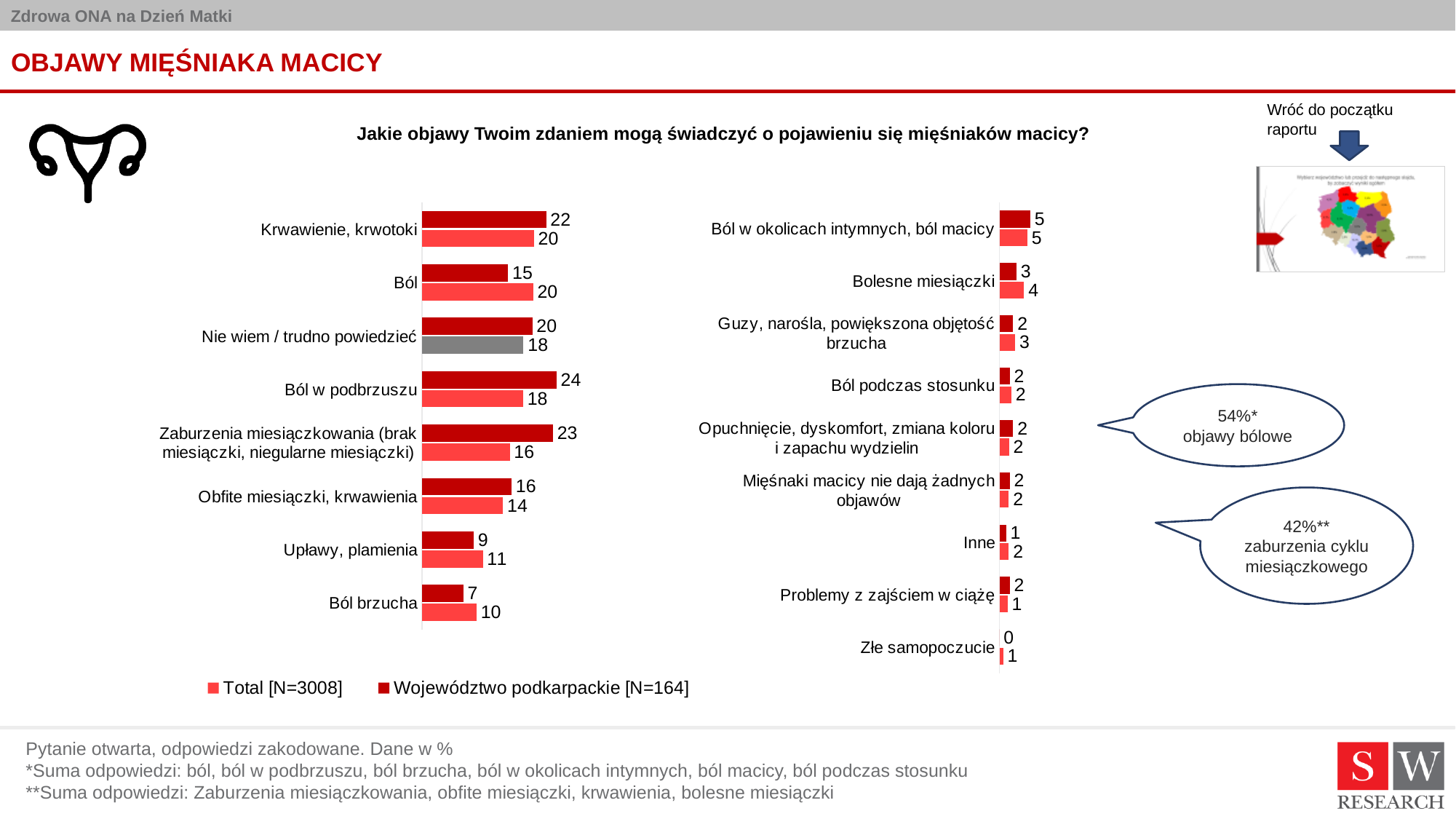
On the right chart, which category has the lowest Województwo podkarpackie [N=164] value? Złe samopoczucie On the left chart, what is the value for Ból w podbrzuszu in the Województwo podkarpackie [N=164] series? 24 What is the question shown as the title above the charts? Jakie objawy Twoim zdaniem mogą świadczyć o pojawieniu się mięśniaków macicy? On the left chart, what is the Total [N=3008] value for Krwawienie, krwotoki? 20 On the left chart, what is the difference between the Województwo podkarpackie and Total values for Zaburzenia miesiączkowania (brak miesiączki, niegularne miesiączki)? 7 On the left chart, for Ból, which series has the larger value: Total [N=3008] or Województwo podkarpackie [N=164]? Total [N=3008] On the left chart, which category has the lowest Total [N=3008] value? Ból brzucha How many series does the legend list? 2 How many categories are shown on the right chart? 9 On the right chart, what is the Total [N=3008] value for Bolesne miesiączki? 4 What type of chart is used on the left side of the slide? Bar chart On the left chart, which category has the highest value in the Województwo podkarpackie [N=164] series? Ból w podbrzuszu